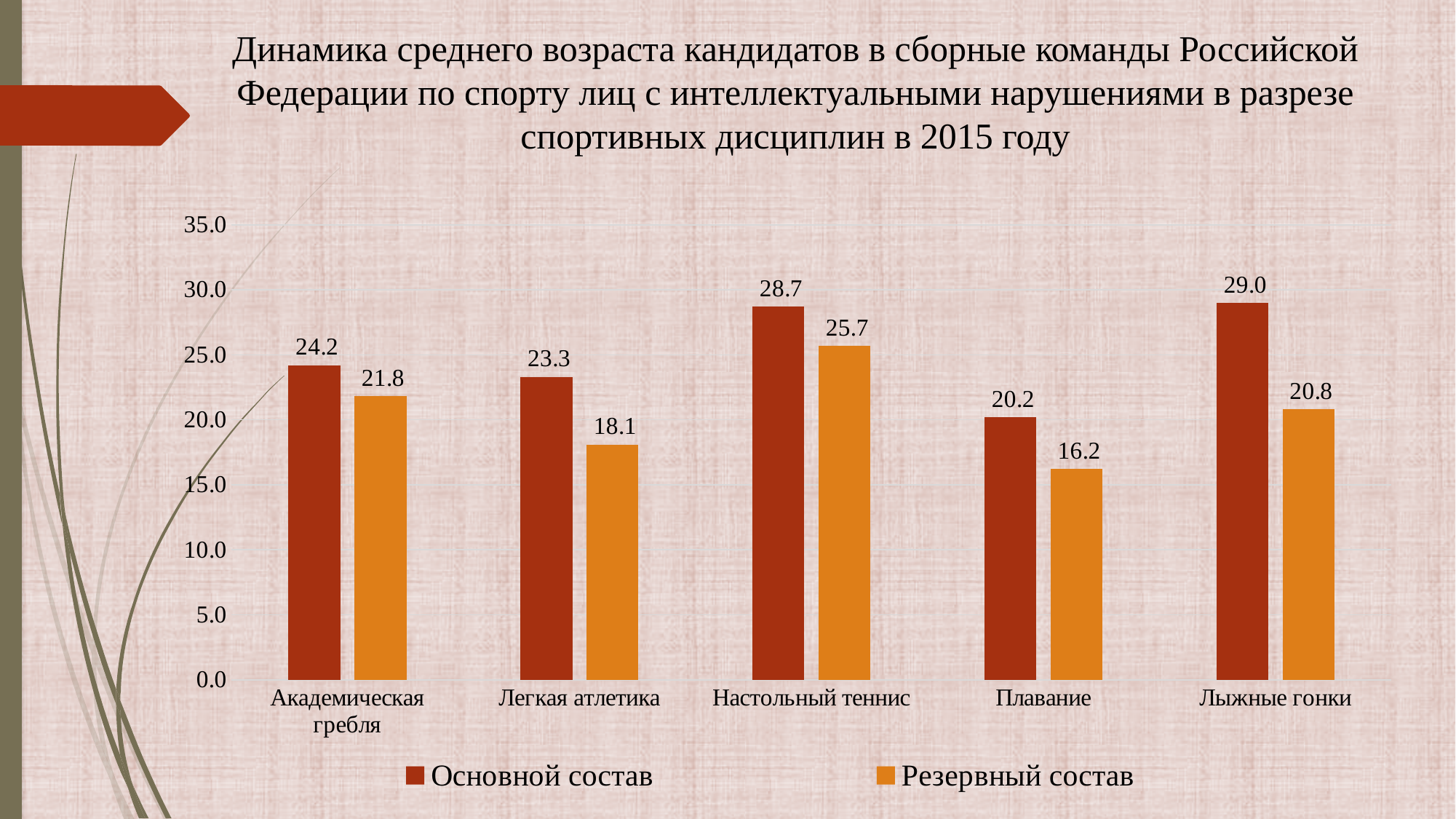
What is the value for Резервный состав in Академическая гребля? 21.8 Which series is shown in orange in the legend? Резервный состав What is the value for Основной состав in Настольный теннис? 28.7 How many series does the legend list? 2 Which category has the lowest value for Резервный состав? Плавание Which category has the highest value for Основной состав? Лыжные гонки What kind of chart is shown on the slide? Bar chart What is the value for Резервный состав in Плавание? 16.2 What is the difference between Основной состав and Резервный состав in Легкая атлетика? 5.2 How many categories are shown on the x axis? 5 Is the value for Резервный состав in Настольный теннис greater or less than 25.0? greater Which is larger in Лыжные гонки: Основной состав or Резервный состав? Основной состав